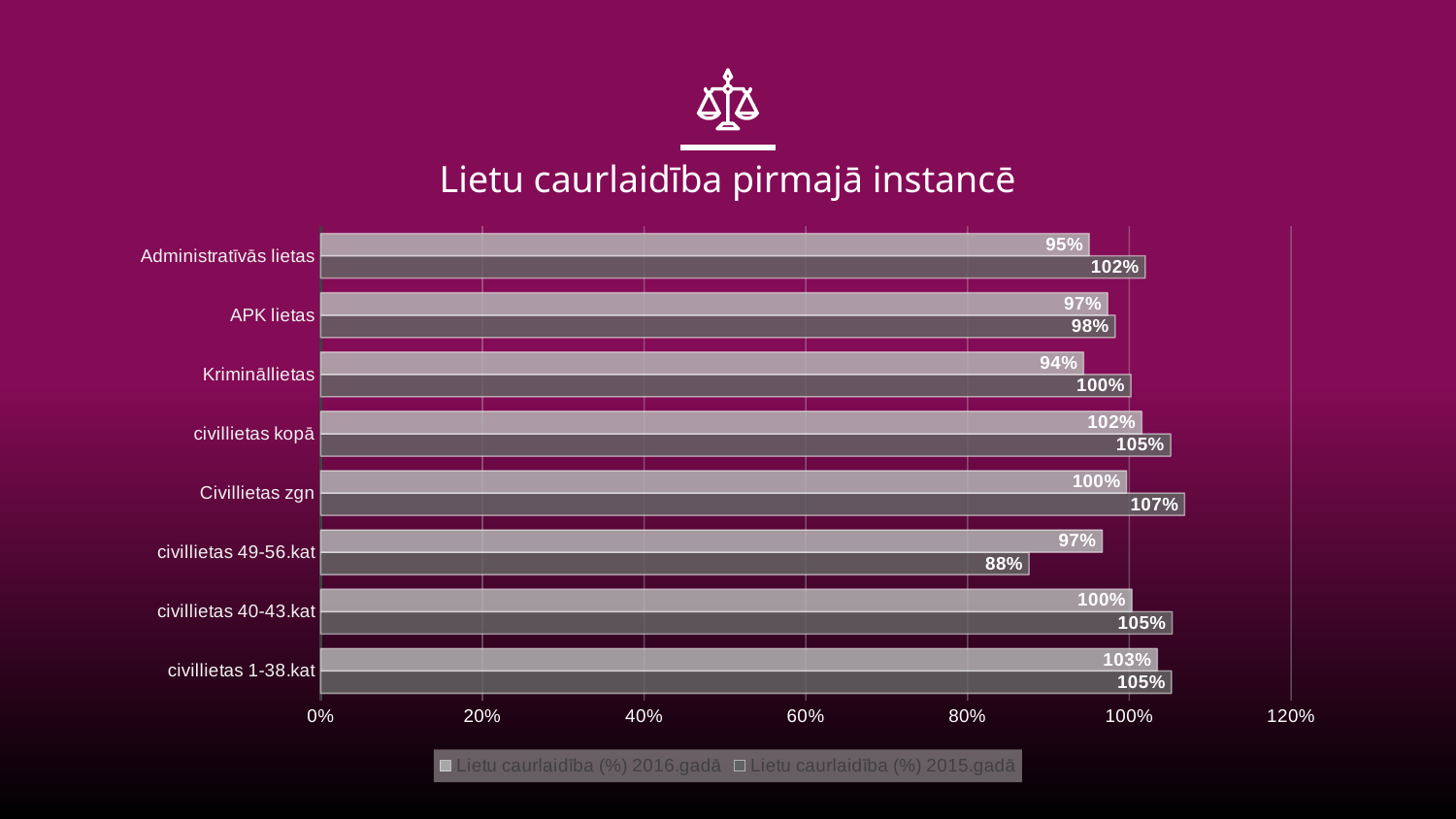
What is the value for civillietas 49-56.kat in the Lietu caurlaidība (%) 2015.gadā series? 88% Which category has the lowest value in the Lietu caurlaidība (%) 2016.gadā series? Krimināllietas Which category has the lowest value in the Lietu caurlaidība (%) 2015.gadā series? civillietas 49-56.kat What is the difference between the 2015.gadā and 2016.gadā values for Administratīvās lietas? 7% How many series does the legend list? 2 For civillietas 49-56.kat, which series has the larger value: 2016.gadā or 2015.gadā? Lietu caurlaidība (%) 2016.gadā What kind of chart is shown on the slide? Bar chart How many categories are shown on the chart? 8 What is the value for Civillietas zgn in the Lietu caurlaidība (%) 2015.gadā series? 107% What is the title of the chart? Lietu caurlaidība pirmajā instancē What is the value for Administratīvās lietas in the Lietu caurlaidība (%) 2016.gadā series? 95% Which category has the highest value in the Lietu caurlaidība (%) 2016.gadā series? civillietas 1-38.kat